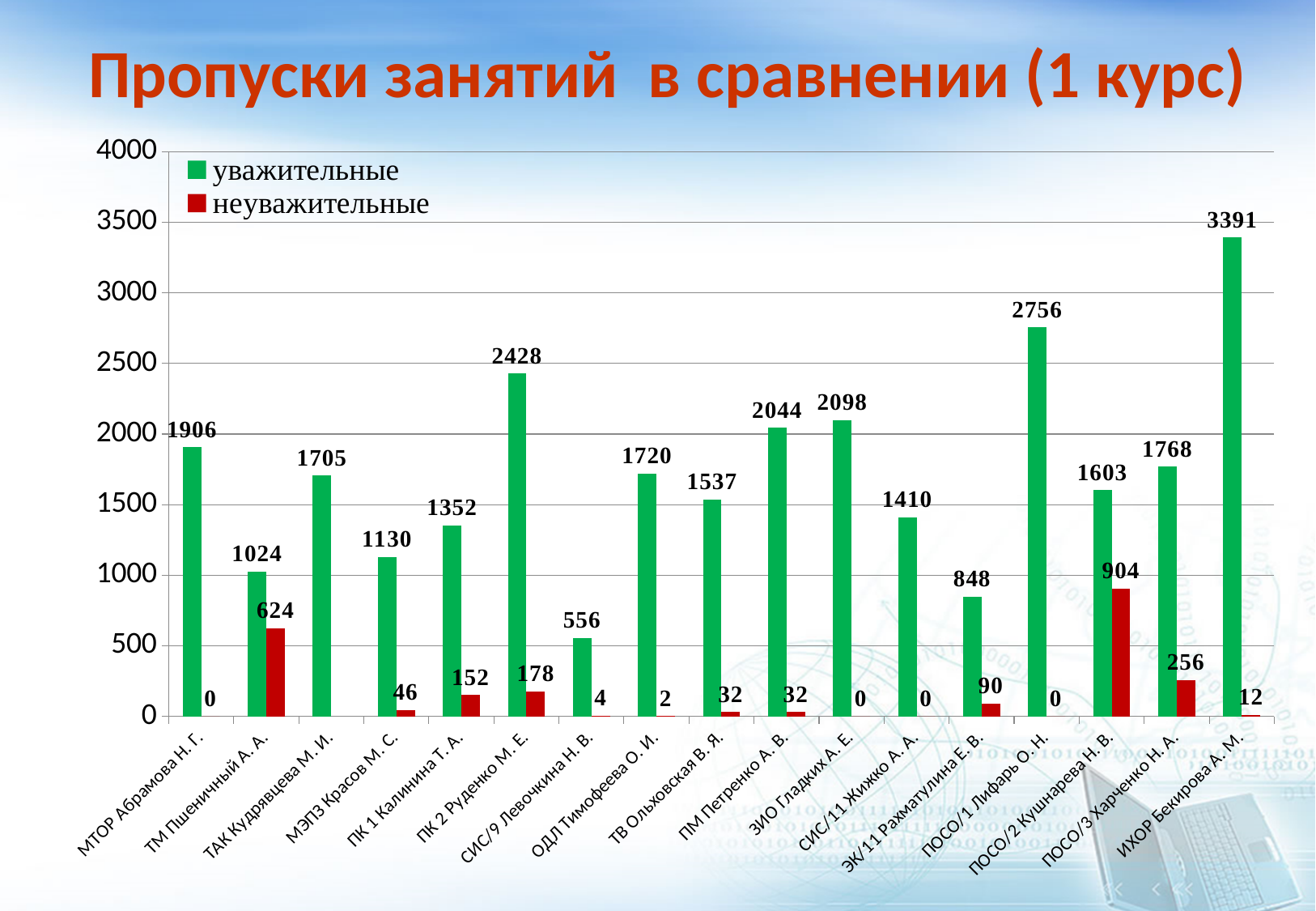
Which category has the highest value of неуважительные? ПОСО/2 Кушнарева Н. В. What is the title of the chart? Пропуски занятий в сравнении (1 курс) Which category has the highest value of уважительные? ИХОР Бекирова А. М. What is the value of неуважительные for ПОСО/2 Кушнарева Н. В.? 904 Is the value of уважительные for ЭК/11 Рахматулина Е. В. greater or less than 1000? less What is the value of уважительные for ПК 2 Руденко М. Е.? 2428 Which is larger: уважительные for ПОСО/1 Лифарь О. Н. or for ПМ Петренко А. В.? ПОСО/1 Лифарь О. Н. Which category has the lowest value of уважительные? СИС/9 Левочкина Н. В. What is the difference between уважительные and неуважительные for ТМ Пшеничный А. А.? 400 What is the value of уважительные for ИХОР Бекирова А. М.? 3391 How many series does the legend list? 2 What type of chart is shown on the slide? bar chart